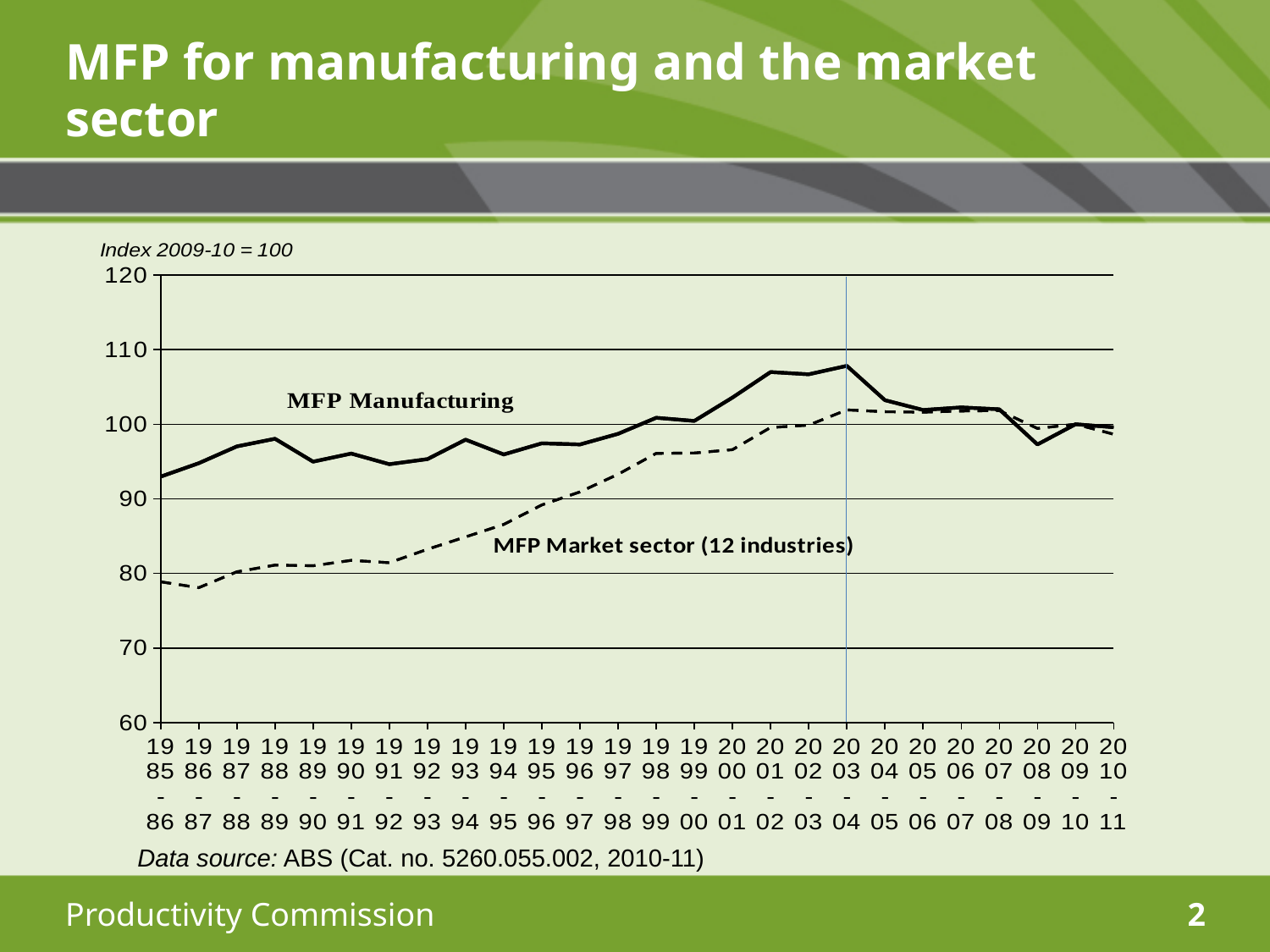
Is the value for MFP Market sector (12 industries) in 1998-99 greater or less than 100? less How many time periods are shown along the x axis? 26 Is the value for MFP Manufacturing in 1985-86 greater or less than 90? greater Is the value for MFP Manufacturing in 2003-04 greater or less than 100? greater In 1985-86, which series has the higher value, MFP Manufacturing or MFP Market sector (12 industries)? MFP Manufacturing What kind of chart is shown on the slide? line chart What is the base year of the index shown on the chart? 2009-10 = 100 How many series are plotted on the chart? 2 Does the MFP Manufacturing series rise or fall from 2003-04 to 2010-11? fall Does the MFP Market sector (12 industries) series generally rise or fall from 1985-86 to 2010-11? rise